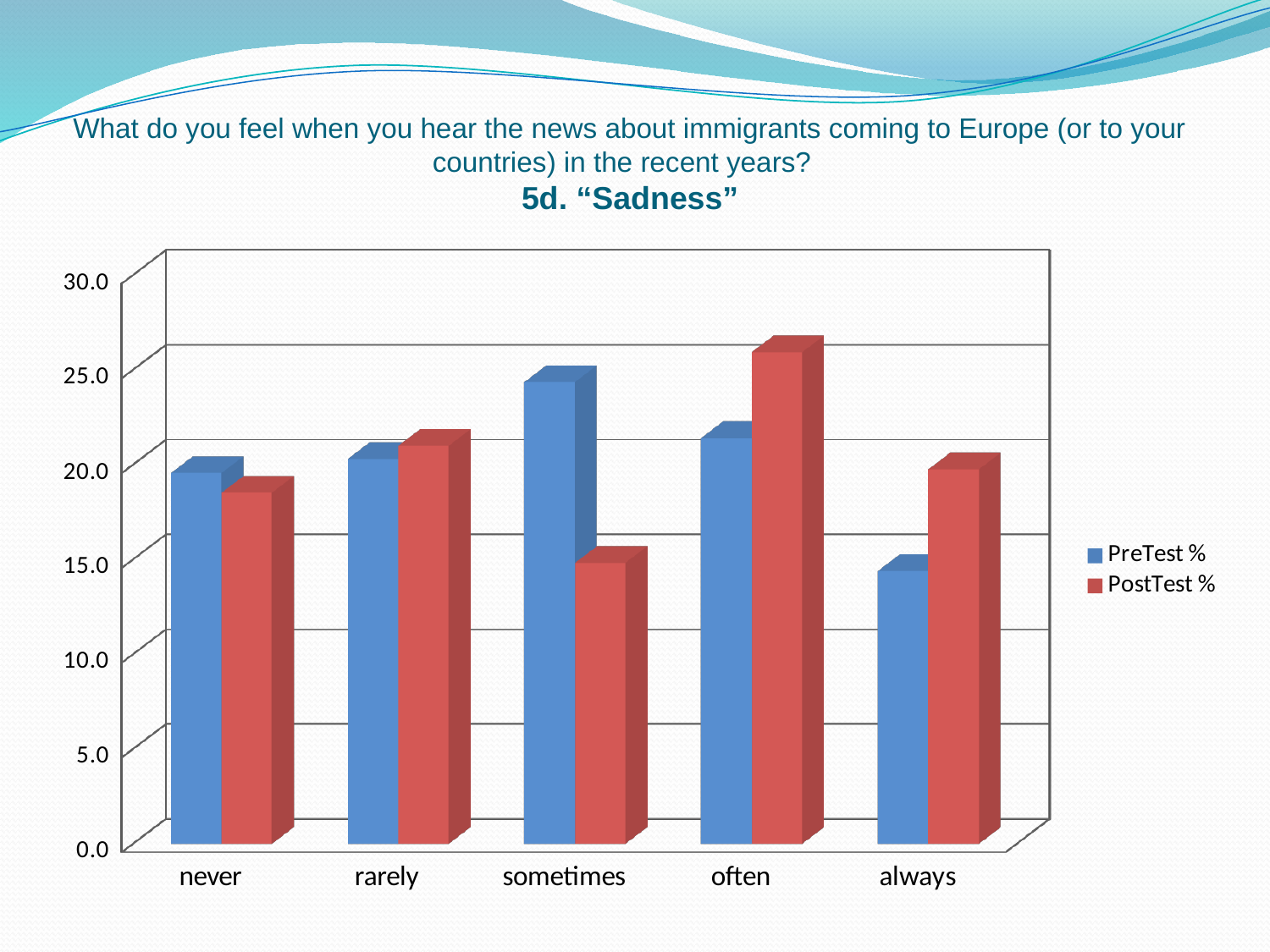
Is the PostTest % value for "sometimes" greater or less than 20.0? less Which category has the highest PreTest % value? sometimes Is the PreTest % value for "sometimes" greater or less than 20.0? greater Which category has the lowest PreTest % value? always Which category has the lowest PostTest % value? sometimes What are the two series names shown in the legend? PreTest % and PostTest % What kind of chart is shown on the slide? bar chart For the category "sometimes", which is larger: PreTest % or PostTest %? PreTest % Which category has the highest PostTest % value? often How many series does the legend list? 2 How many categories are shown on the x axis? 5 For the category "always", which is larger: PreTest % or PostTest %? PostTest %